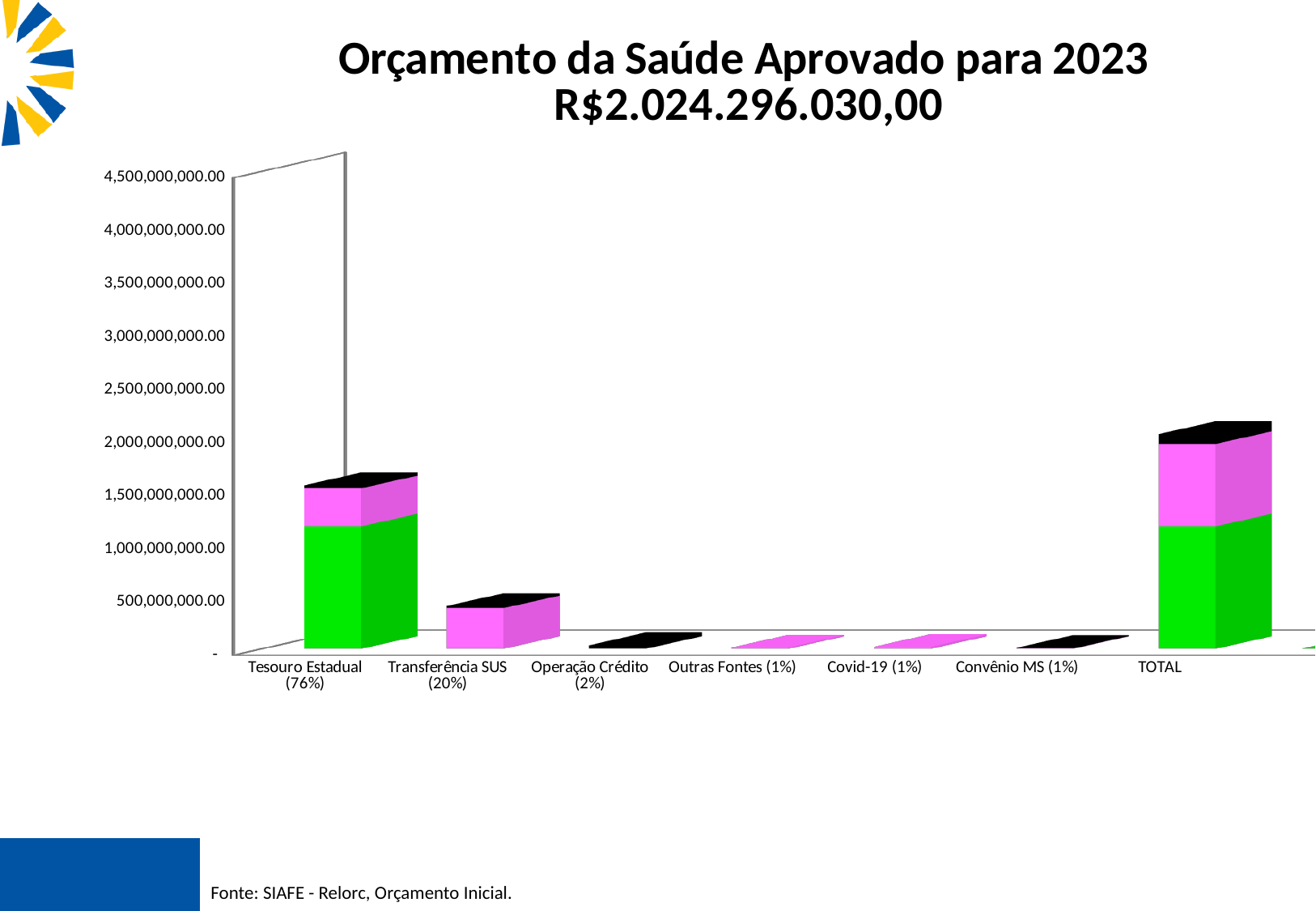
Which category has the tallest bar in the chart? TOTAL Is the value for Transferência SUS greater or less than 1,000,000,000.00? less Which is larger, the bar for Tesouro Estadual or the bar for Transferência SUS? Tesouro Estadual What percentage share is shown in the label for Transferência SUS? 20% Excluding TOTAL, which funding source has the tallest bar? Tesouro Estadual (76%) Is the value for Tesouro Estadual greater or less than 1,000,000,000.00? greater What source is cited below the chart? Fonte: SIAFE - Relorc, Orçamento Inicial. Is the value for TOTAL greater or less than 1,500,000,000.00? greater What is the title of the chart? Orçamento da Saúde Aprovado para 2023 R$2.024.296.030,00 How many categories are shown along the x axis of the chart? 7 What kind of chart is shown on the slide? bar chart